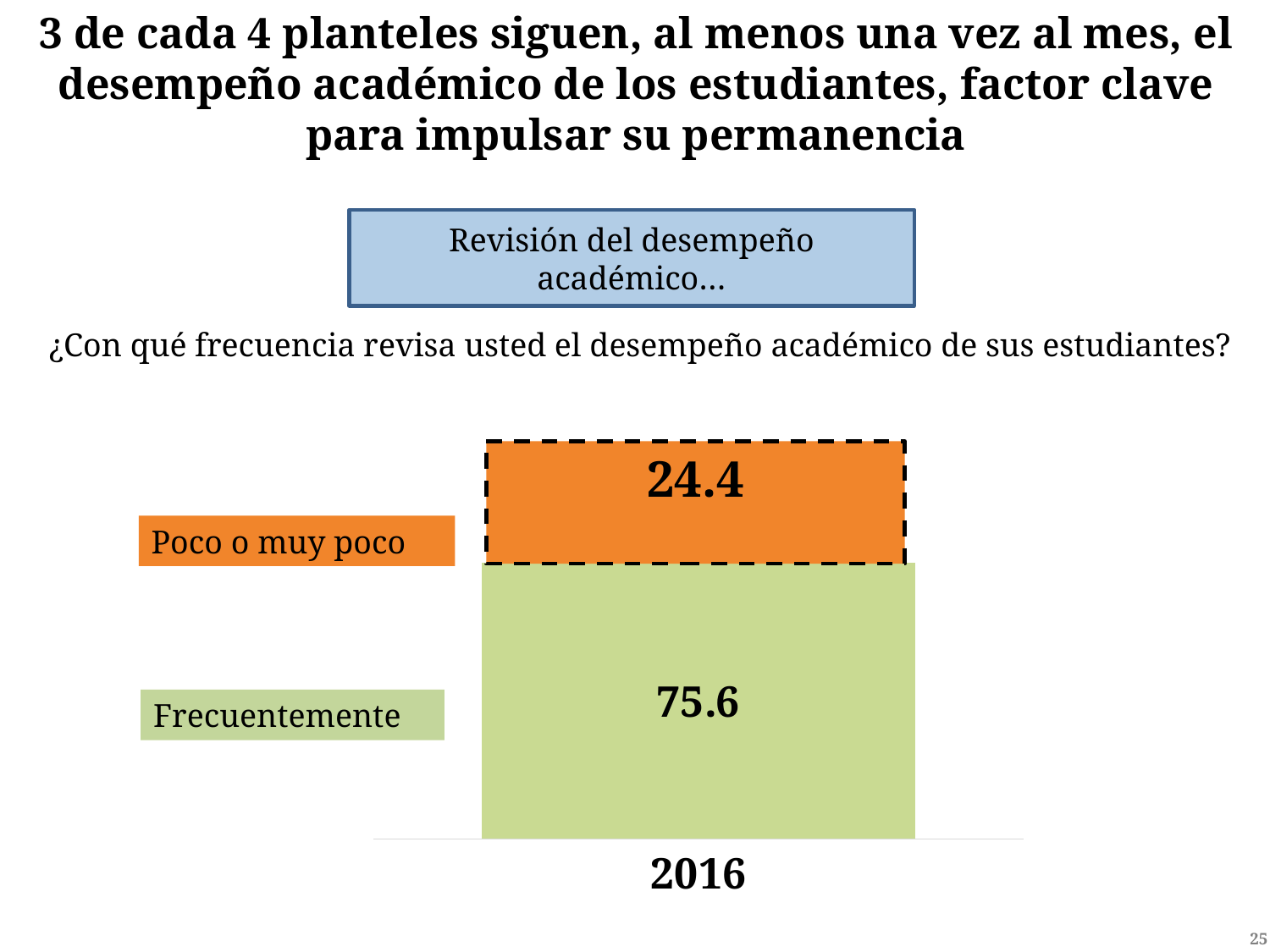
What is the difference between the "Frecuentemente" and "Poco o muy poco" values in 2016? 51.2 Which series has the larger value in 2016, "Frecuentemente" or "Poco o muy poco"? Frecuentemente What is the value for "Poco o muy poco" in 2016? 24.4 What is the total of the stacked bar for 2016? 100 What kind of chart is shown on the slide? Stacked bar chart Which series has the smallest value in 2016? Poco o muy poco Which year is shown on the x axis of the chart? 2016 How many categories are shown on the x axis? 1 What colour is the "Poco o muy poco" segment of the bar? Orange How many series does the legend list? 2 What is the value for "Frecuentemente" in 2016? 75.6